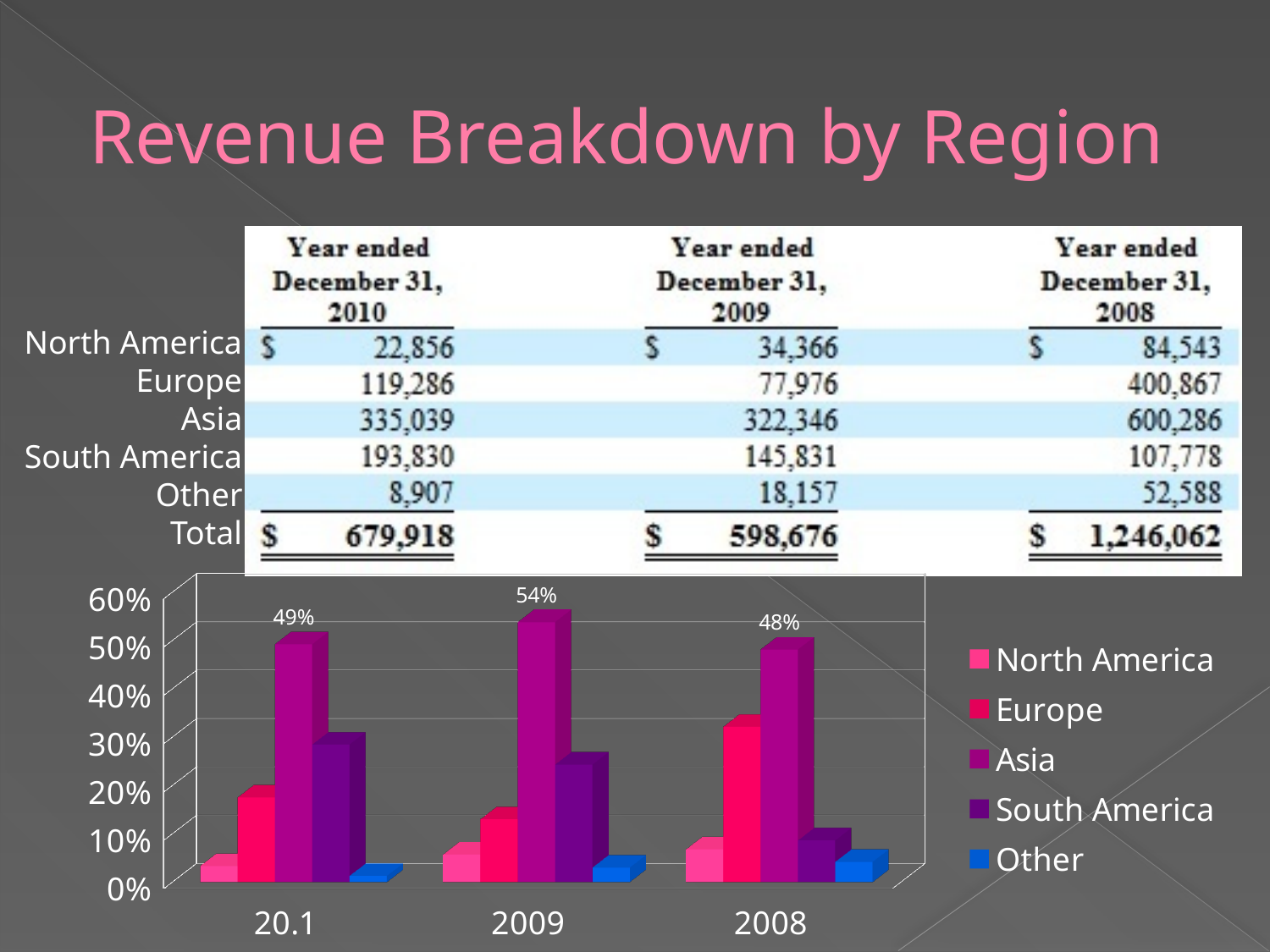
How many year groups are plotted along the x axis of the chart? 3 In which year group does Asia reach its highest share on the chart? 2009 Is the value for Europe in 2009 greater or less than 10%? greater Which region has the highest share in 2009 on the chart? Asia What is the difference between Asia's share in 2009 and in 2008 on the chart? 6% Is the value for South America in 2009 greater or less than 30%? less How many series does the chart legend list? 5 What kind of chart is shown at the bottom of the slide? Bar chart What is the labelled value for Asia in 2008 on the chart? 48% What is the labelled value for Asia in 2009 on the chart? 54% What is the labelled value for Asia in the leftmost group (labelled 20.1) on the chart? 49% In 2008, which is larger on the chart: Europe or South America? Europe